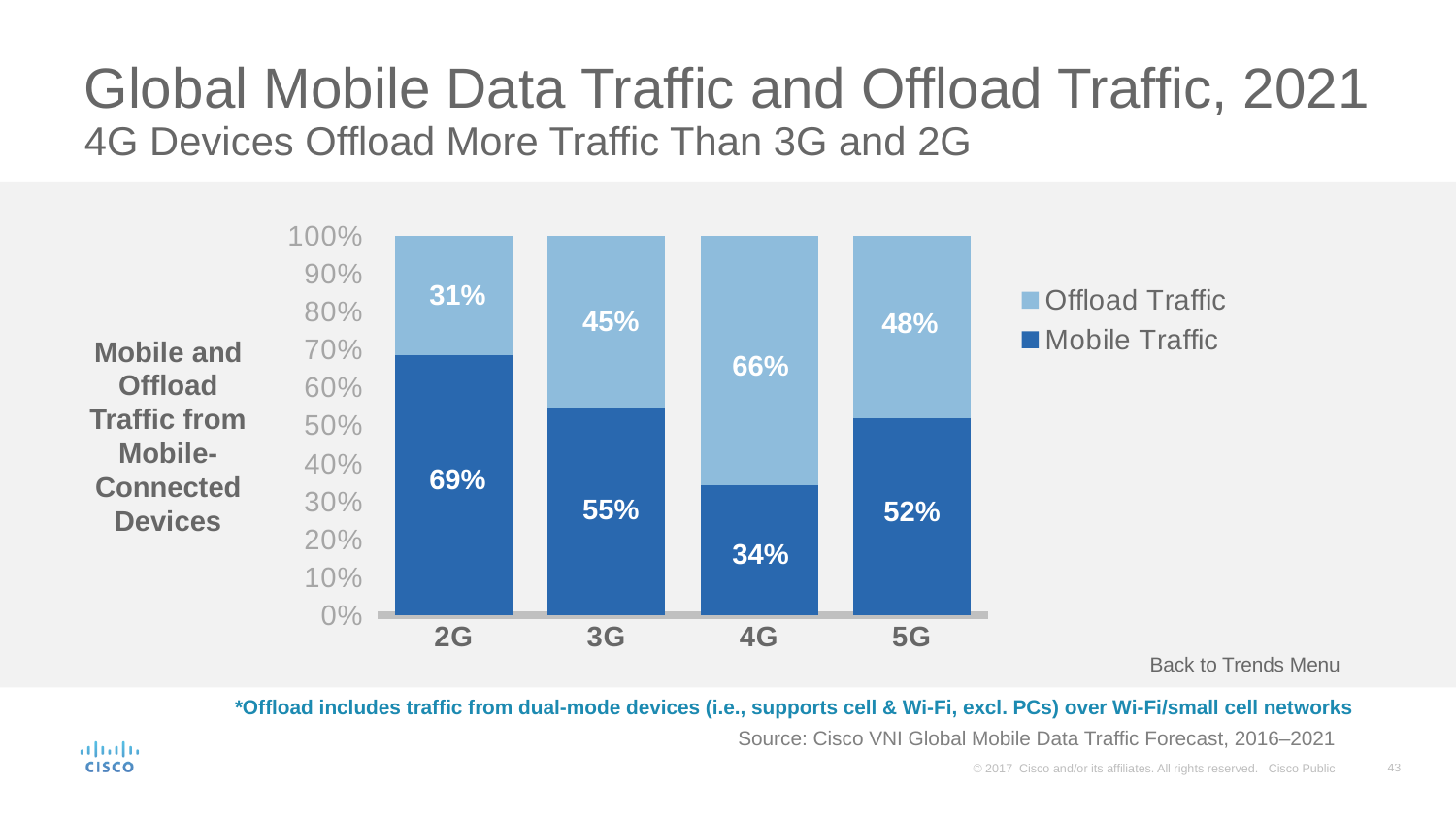
What kind of chart is shown on the slide? Stacked bar chart Which series is shown in the darker blue colour? Mobile Traffic What is the Mobile Traffic share for 2G? 69% What is the Offload Traffic share for 4G? 66% How many categories are shown on the x axis? 4 What is the Mobile Traffic share for 5G? 52% Which category has the lowest Mobile Traffic share? 4G Which is larger, the Offload Traffic share for 5G or for 3G? 5G Which category has the highest Offload Traffic share? 4G What is the difference between the Mobile Traffic share for 2G and for 3G? 14% What is the Offload Traffic share for 3G? 45% How many series does the legend list? 2